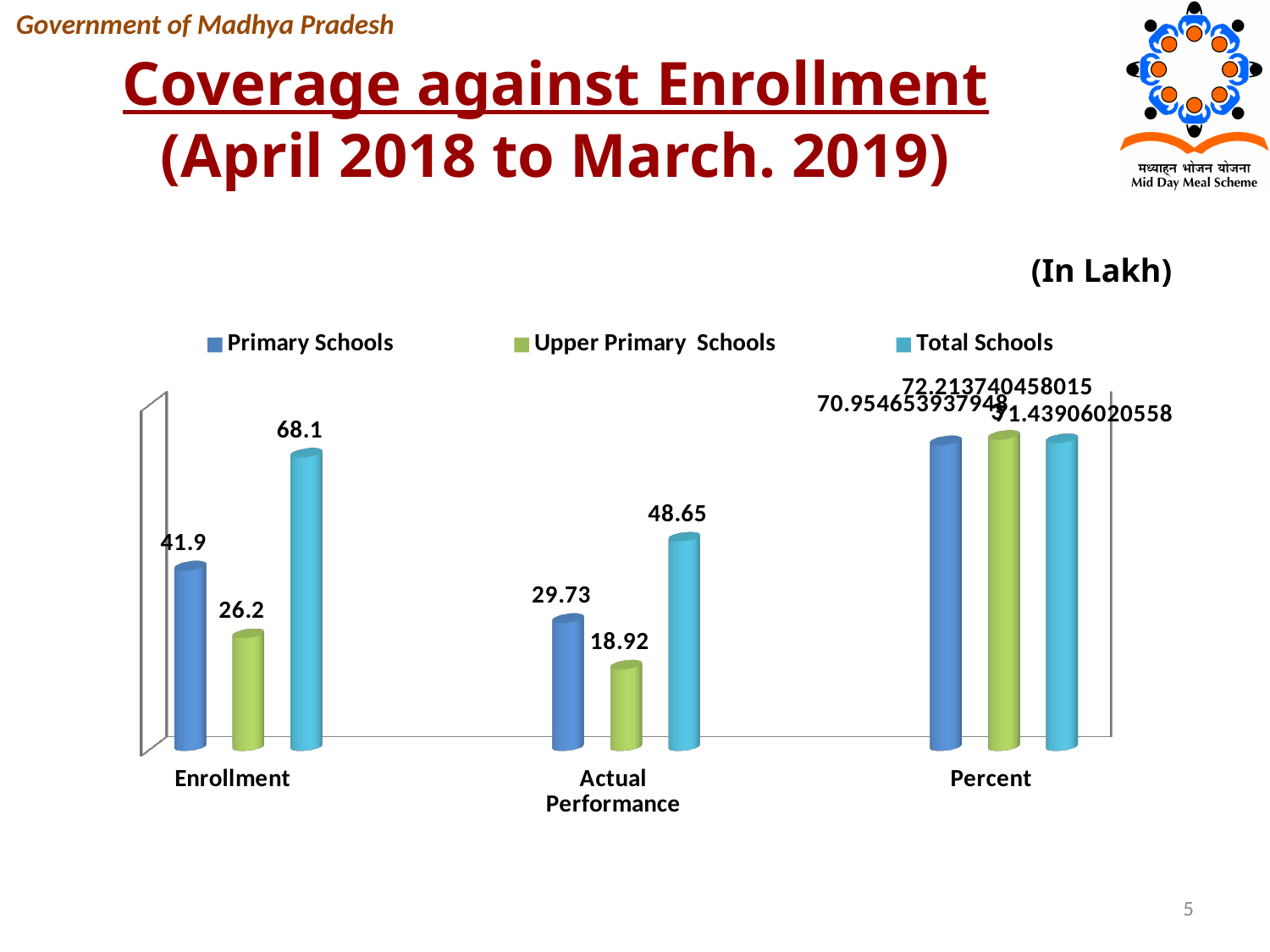
What is the value for Primary Schools in the Enrollment category? 41.9 What kind of chart is shown on the slide? Bar chart Which series has the highest value in the Actual Performance category? Total Schools Which series has the lowest value in the Enrollment category? Upper Primary Schools How many series does the legend list? 3 What is the value for Total Schools in the Actual Performance category? 48.65 What is the value for Total Schools in the Enrollment category? 68.1 What is the difference between the Total Schools values for Enrollment and Actual Performance? 19.45 Which is larger: the Primary Schools value for Enrollment or the Primary Schools value for Actual Performance? Enrollment What is the value for Upper Primary Schools in the Actual Performance category? 18.92 What is the value for Upper Primary Schools in the Enrollment category? 26.2 What is the value for Primary Schools in the Actual Performance category? 29.73